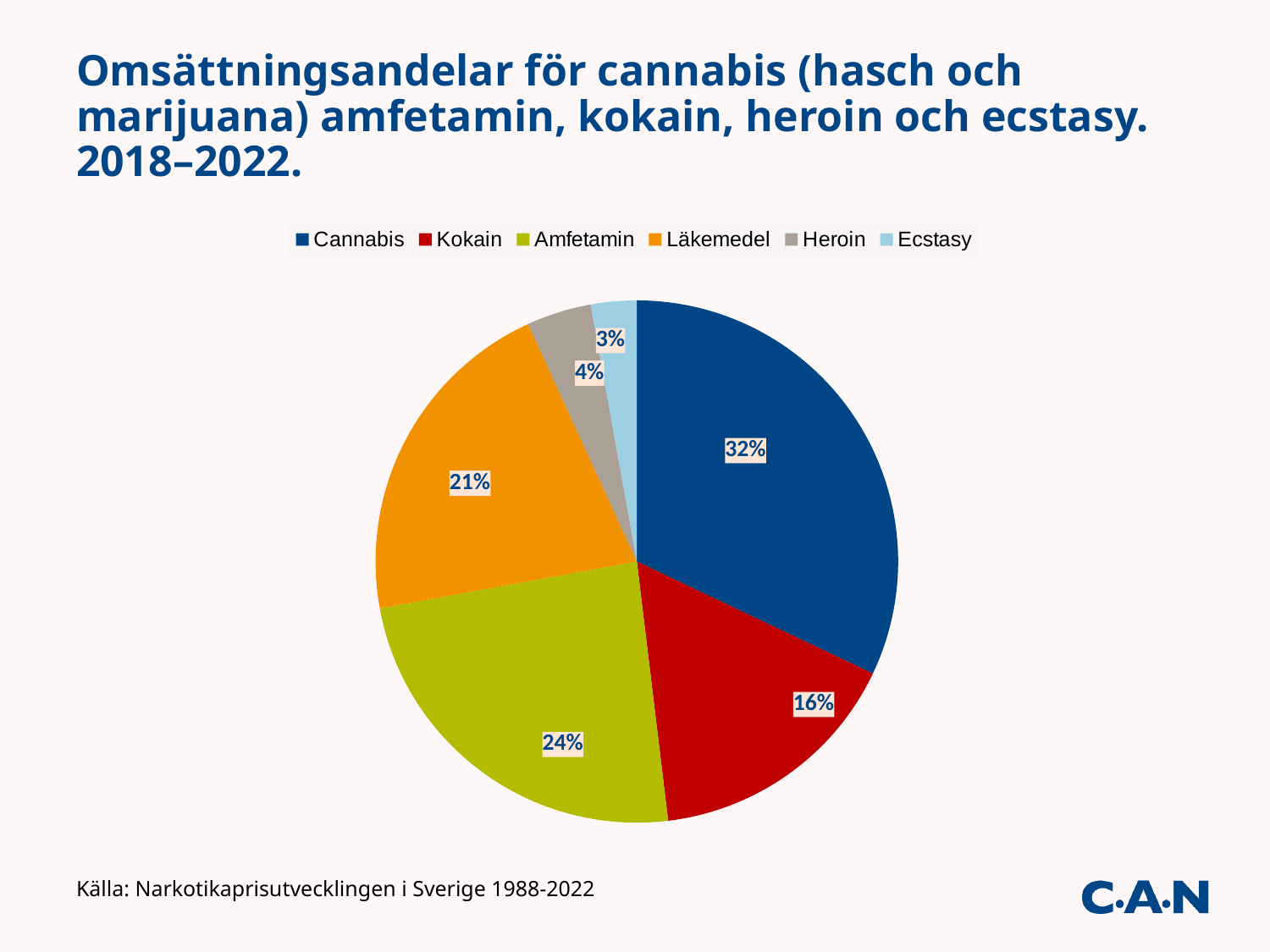
What kind of chart is shown on the slide? Pie chart How many categories does the pie chart show? 6 What is the difference in percentage points between Cannabis and Kokain? 16 What share of the pie does Cannabis account for? 32% What is the value shown for Kokain? 16% What is the value shown for Ecstasy? 3% What is the value shown for Heroin? 4% Which category has the smallest share of the pie? Ecstasy What is the value shown for Amfetamin? 24% Which category has the largest share of the pie? Cannabis What is the value shown for Läkemedel? 21% Which is larger, the share for Amfetamin or the share for Läkemedel? Amfetamin